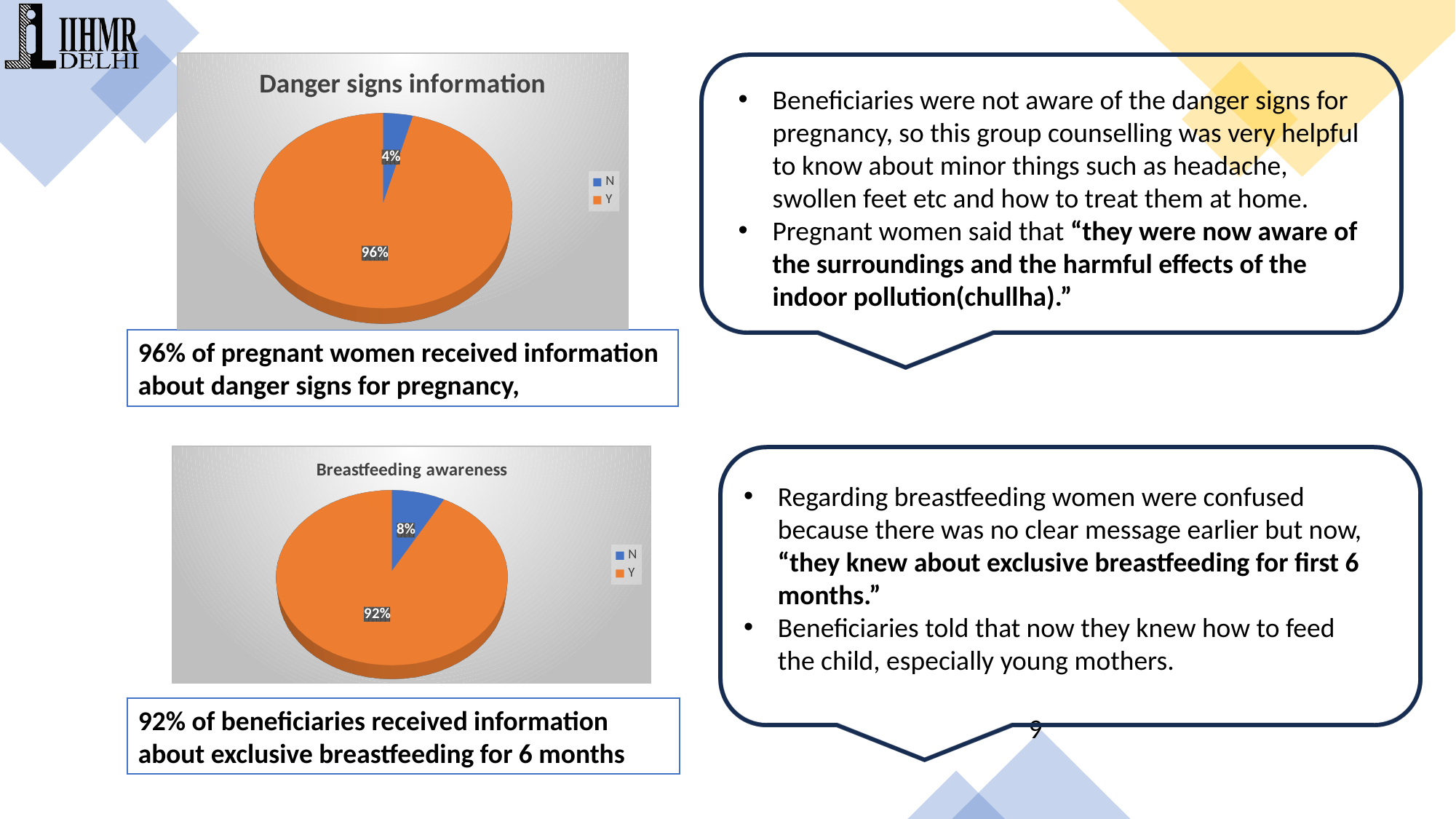
In the 'Breastfeeding awareness' chart, what is the difference between the Y and N shares? 84% In the 'Danger signs information' chart, what colour is the Y slice? Orange What kind of chart is the 'Breastfeeding awareness' chart? Pie chart How many categories does the legend of the 'Breastfeeding awareness' chart list? 2 In the 'Breastfeeding awareness' chart, which category has the smallest slice? N In the 'Danger signs information' chart, which category has the largest slice? Y In the 'Danger signs information' chart, what share of the pie is labelled Y? 96% What kind of chart is the 'Danger signs information' chart? Pie chart In the 'Breastfeeding awareness' chart, what share of the pie is labelled N? 8% In the 'Breastfeeding awareness' chart, what share of the pie is labelled Y? 92% In the 'Danger signs information' chart, what is the difference between the Y and N shares? 92%